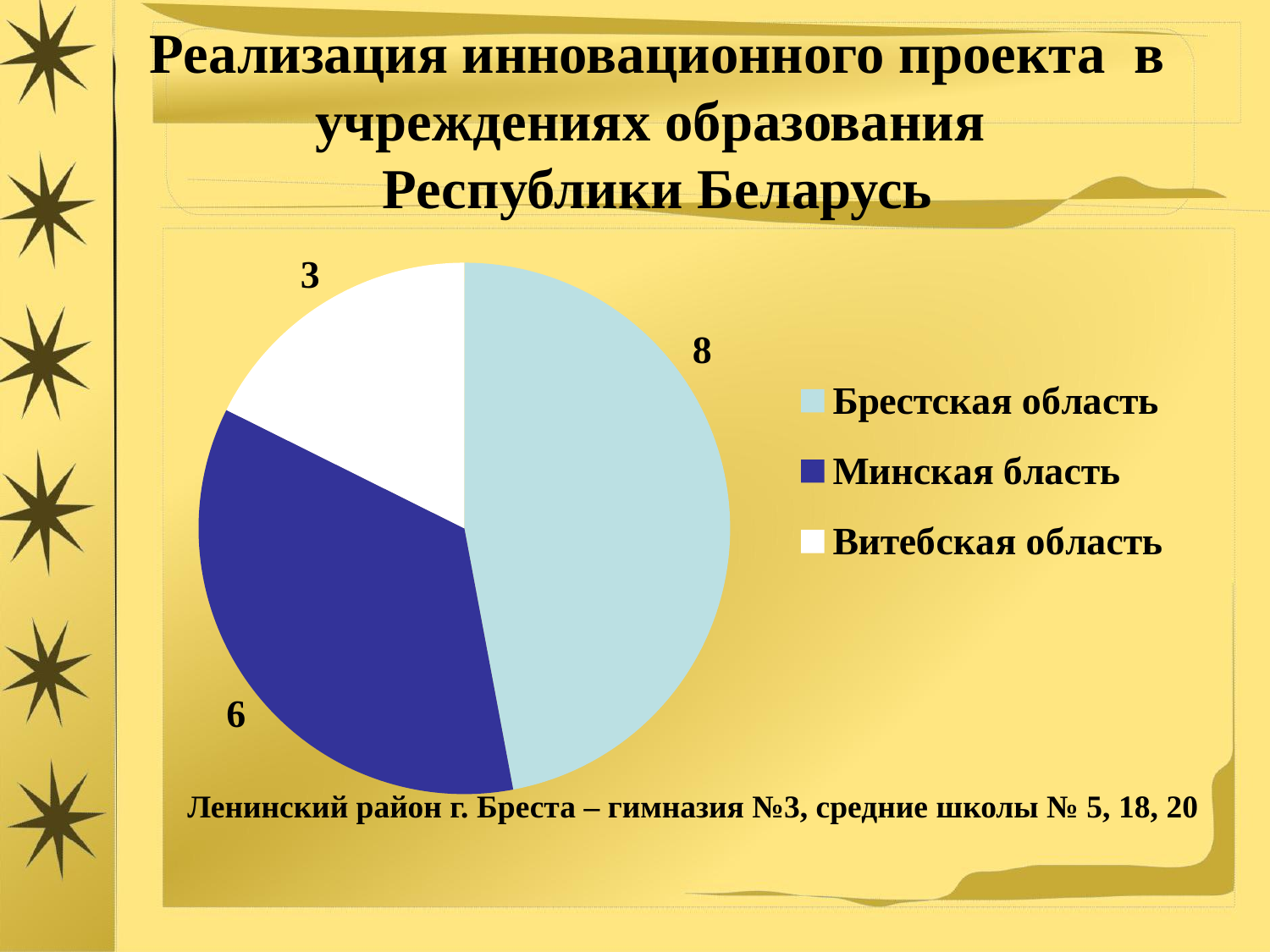
What is the value for Брестская область? 8 What is the difference between the values for Брестская область and Витебская область? 5 Which region has the largest slice of the pie? Брестская область Which is larger, the value for Минская бласть or the value for Витебская область? Минская бласть What is the difference between the values for Брестская область and Минская бласть? 2 What is the value for Витебская область? 3 Which colour represents Минская бласть in the legend? dark blue What is the value for Минская бласть? 6 How many slices does the pie chart have? 3 What kind of chart is shown on the slide? pie chart What is the total of all the values shown in the pie chart? 17 Which region has the smallest slice of the pie? Витебская область